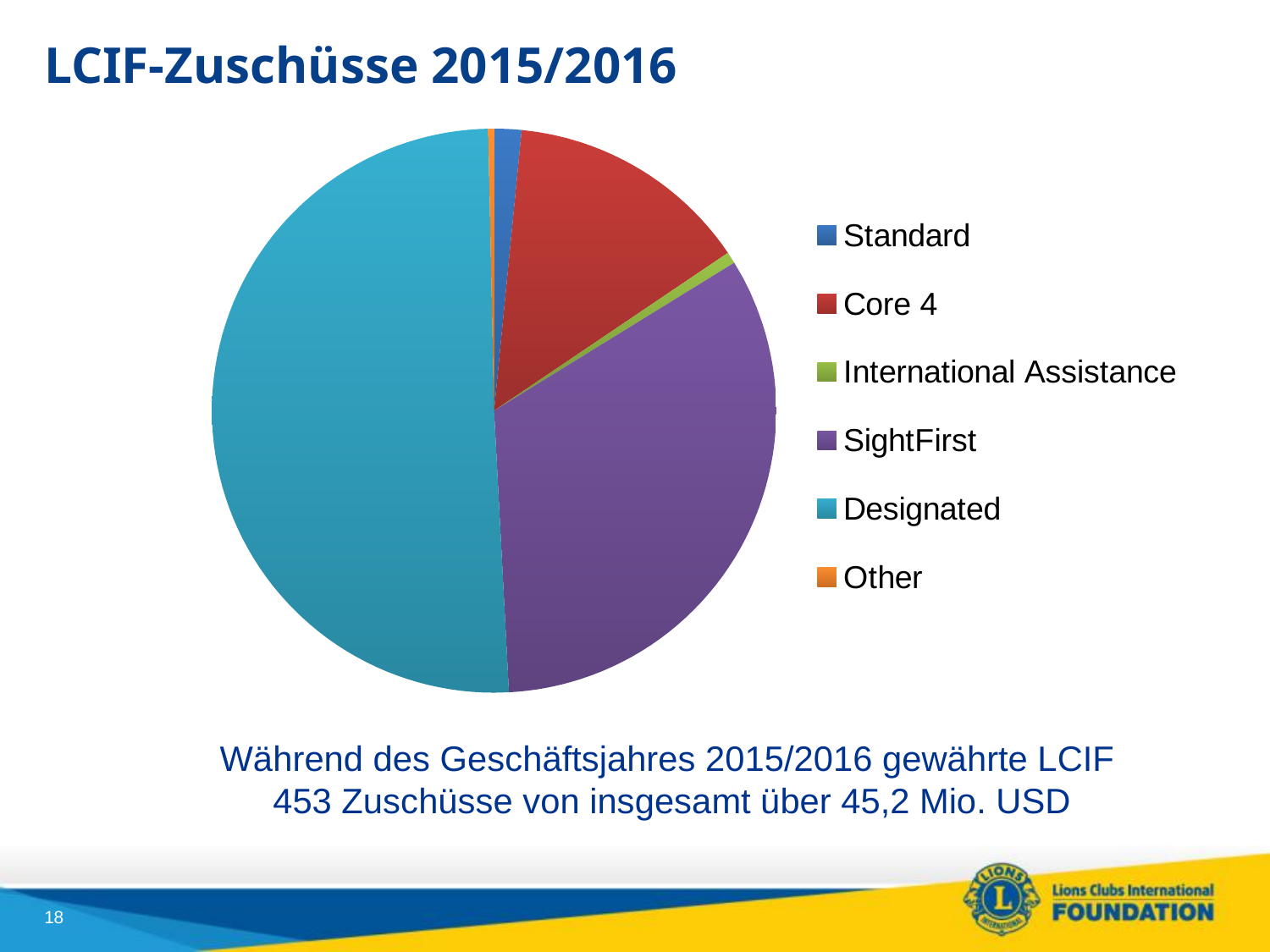
How many categories does the pie chart show? 6 Which slice is larger, Core 4 or Standard? Core 4 Which category has the smallest slice of the pie? Other What is the title of the slide containing the chart? LCIF-Zuschüsse 2015/2016 Which slice is larger, Standard or International Assistance? Standard How many entries does the legend list? 6 What is the second entry listed in the legend? Core 4 Which category has the largest slice of the pie? Designated What kind of chart is shown on the slide? pie chart Which slice is larger, Designated or SightFirst? Designated